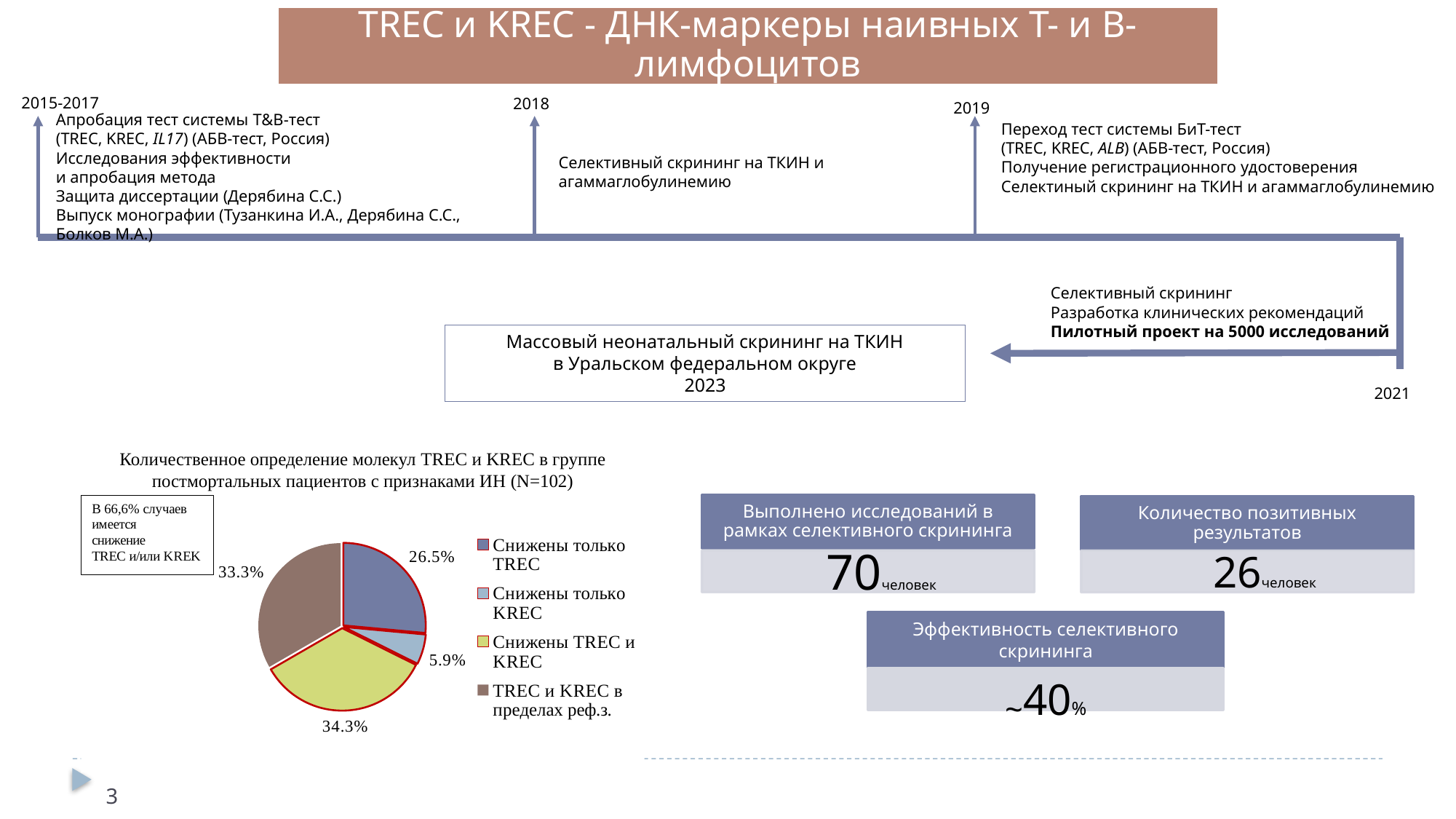
How many entries does the pie chart legend list? 4 What kind of chart is shown on the slide? pie chart Which category has the smallest slice of the pie? Снижены только KREC Which is larger: the "Снижены только TREC" slice or the "TREC и KREC в пределах реф.з." slice? TREC и KREC в пределах реф.з. What share of the pie is labelled "Снижены только KREC"? 5.9% How many slices does the pie chart have? 4 What share of the pie is labelled "Снижены только TREC"? 26.5% What share of the pie is labelled "TREC и KREC в пределах реф.з."? 33.3% Which category has the largest slice of the pie? Снижены TREC и KREC What share of the pie is labelled "Снижены TREC и KREC"? 34.3% What is the difference between the "Снижены только TREC" slice and the "Снижены только KREC" slice? 20.6% What colour is the "Снижены TREC и KREC" slice in the pie chart? yellow-green